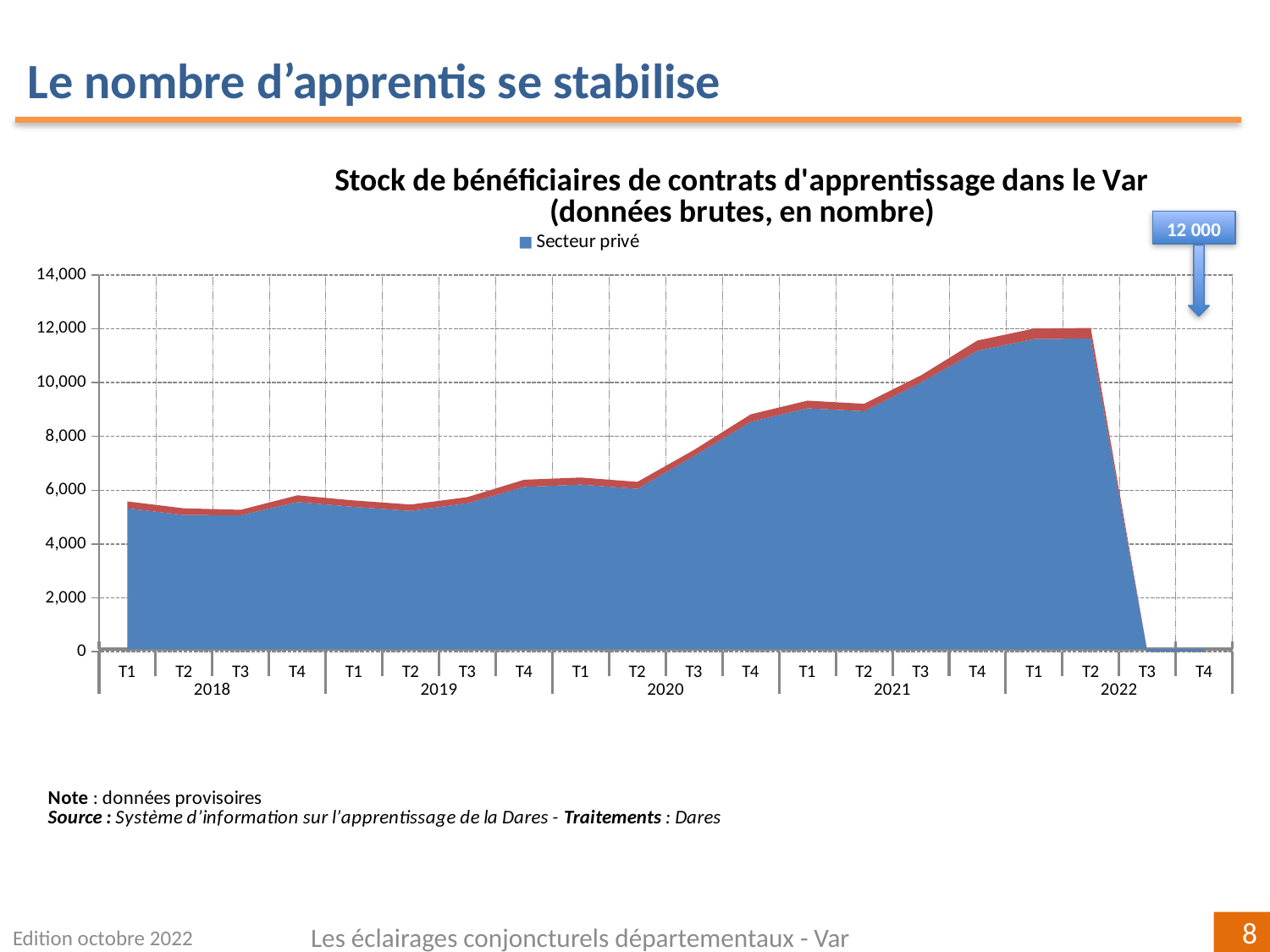
Is the value for T1 2021 greater or less than 10,000? less What is the name of the series shown in the legend? Secteur privé Which is larger, the value for T2 2020 or the value for T4 2020? T4 2020 What is the title of the chart? Stock de bénéficiaires de contrats d'apprentissage dans le Var (données brutes, en nombre) Do the values generally rise or fall from T1 2018 to T2 2022? rise Is the value for T1 2018 greater or less than 4,000? greater How many series does the chart legend list? 1 What kind of chart is shown on the slide? Area chart Is the value for T4 2020 greater or less than 8,000? greater Which is larger, the value for T1 2018 or the value for T2 2022? T2 2022 How many years are labelled along the x axis? 5